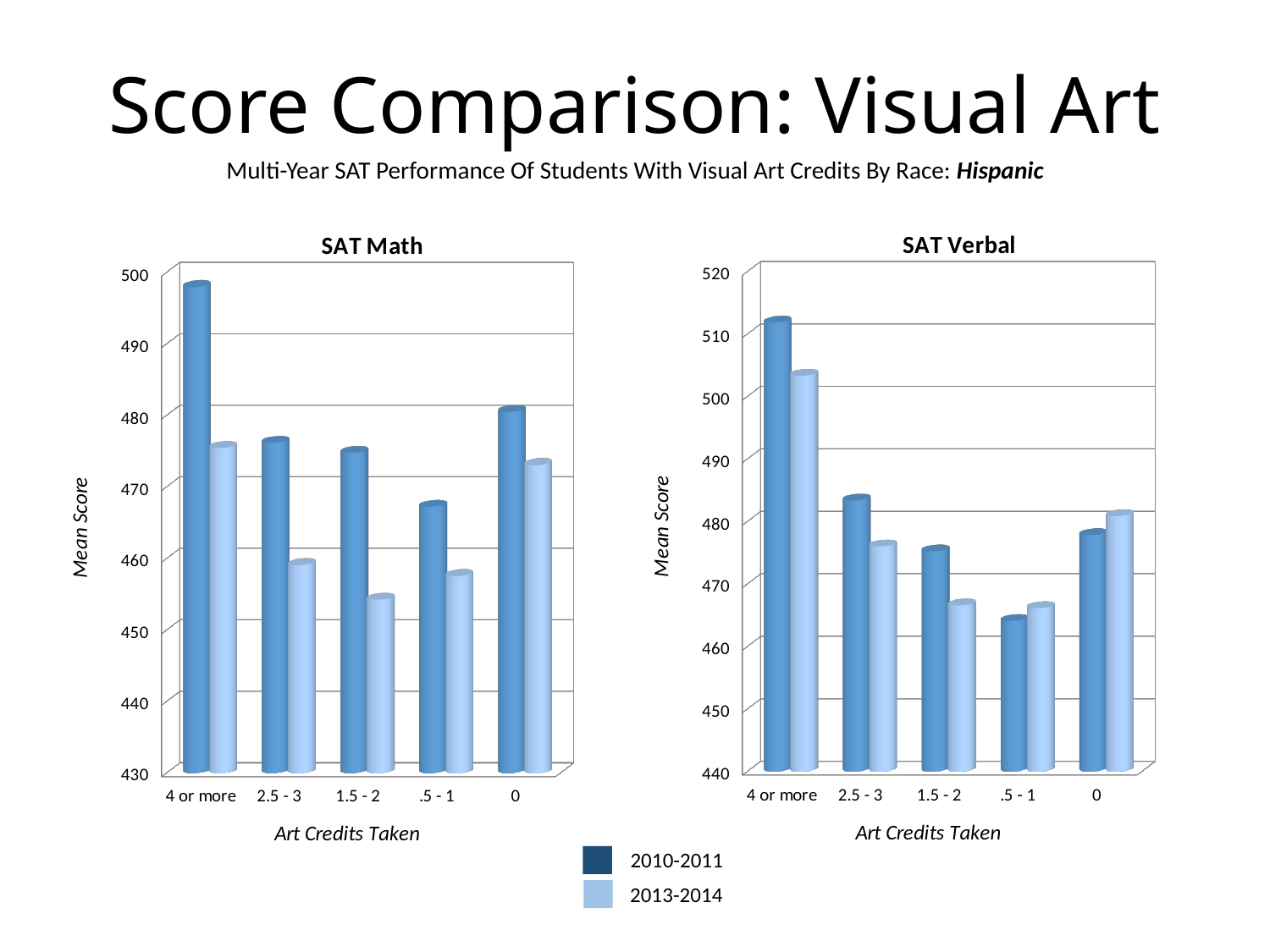
In the SAT Verbal chart, which art-credit category has the highest 2013-2014 mean score? 4 or more In the SAT Math chart, which art-credit category has the lowest 2010-2011 mean score? .5 - 1 In the SAT Math chart, for the '4 or more' category, which series has the larger value: 2010-2011 or 2013-2014? 2010-2011 In the SAT Math chart, which art-credit category has the highest 2010-2011 mean score? 4 or more How many series does the legend list for the charts? 2 In the SAT Math chart, is the 2010-2011 value for '4 or more' greater or less than 490? greater In the SAT Verbal chart, which art-credit category has the lowest 2010-2011 mean score? .5 - 1 In the SAT Verbal chart, is the 2013-2014 value for '1.5 - 2' greater or less than 470? less In the SAT Math chart, is the 2013-2014 value for '0' credits greater or less than 470? greater How many art-credit categories are shown on the x axis of the SAT Verbal chart? 5 What is the y-axis title on the SAT Verbal chart? Mean Score What kind of chart is the SAT Math chart? bar chart